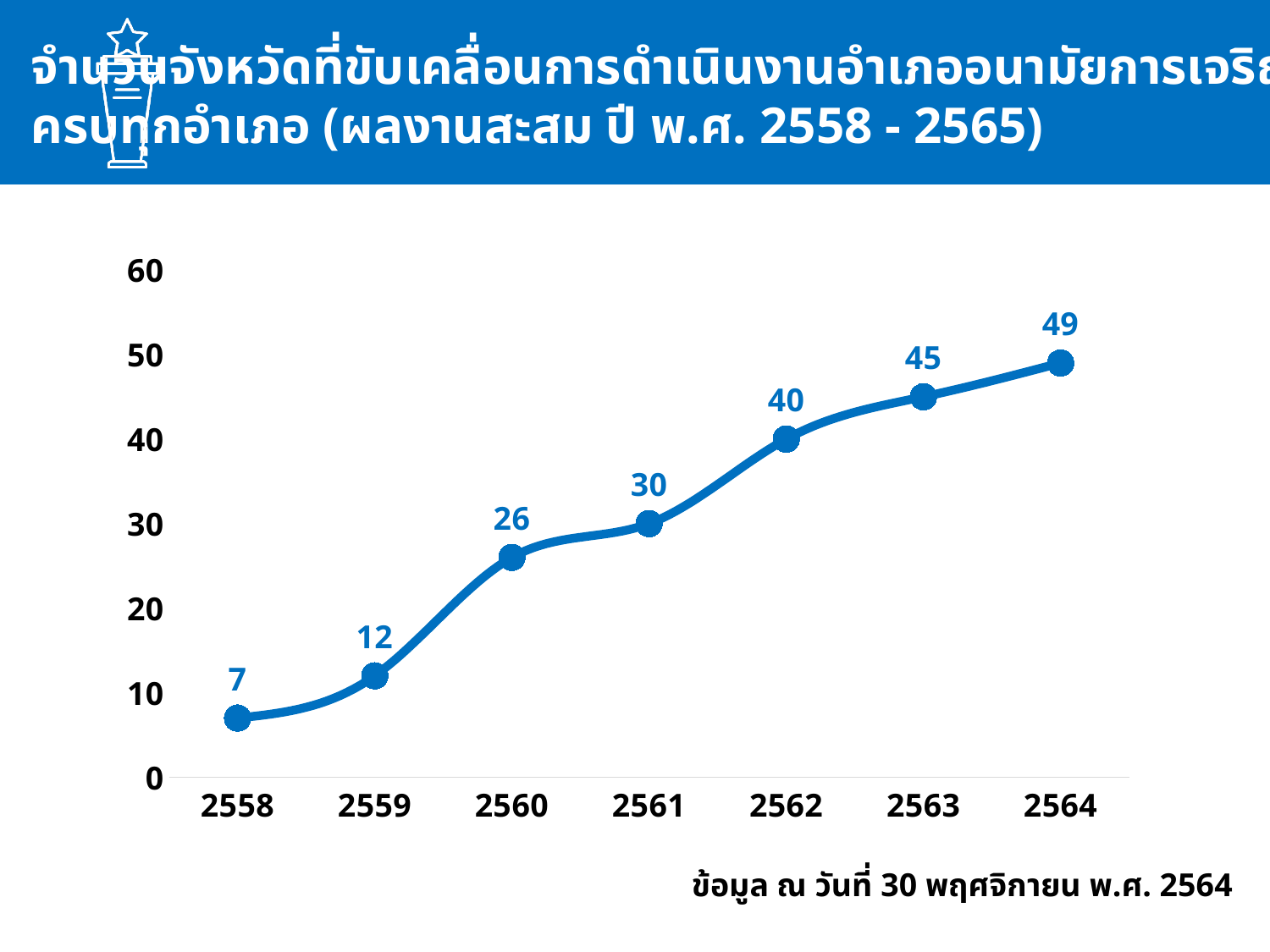
What is the value for 2561? 30 What is the highest value shown on the vertical axis? 60 Do the values rise or fall from 2558 to 2564? rise Which is larger, the value for 2559 or the value for 2563? 2563 Which year has the highest value? 2564 What is the difference between the values for 2564 and 2558? 42 What is the difference between the values for 2562 and 2560? 14 What kind of chart is shown on the slide? line chart How many data points are plotted on the chart? 7 What is the value for 2558? 7 What is the value for 2564? 49 Which year has the lowest value? 2558